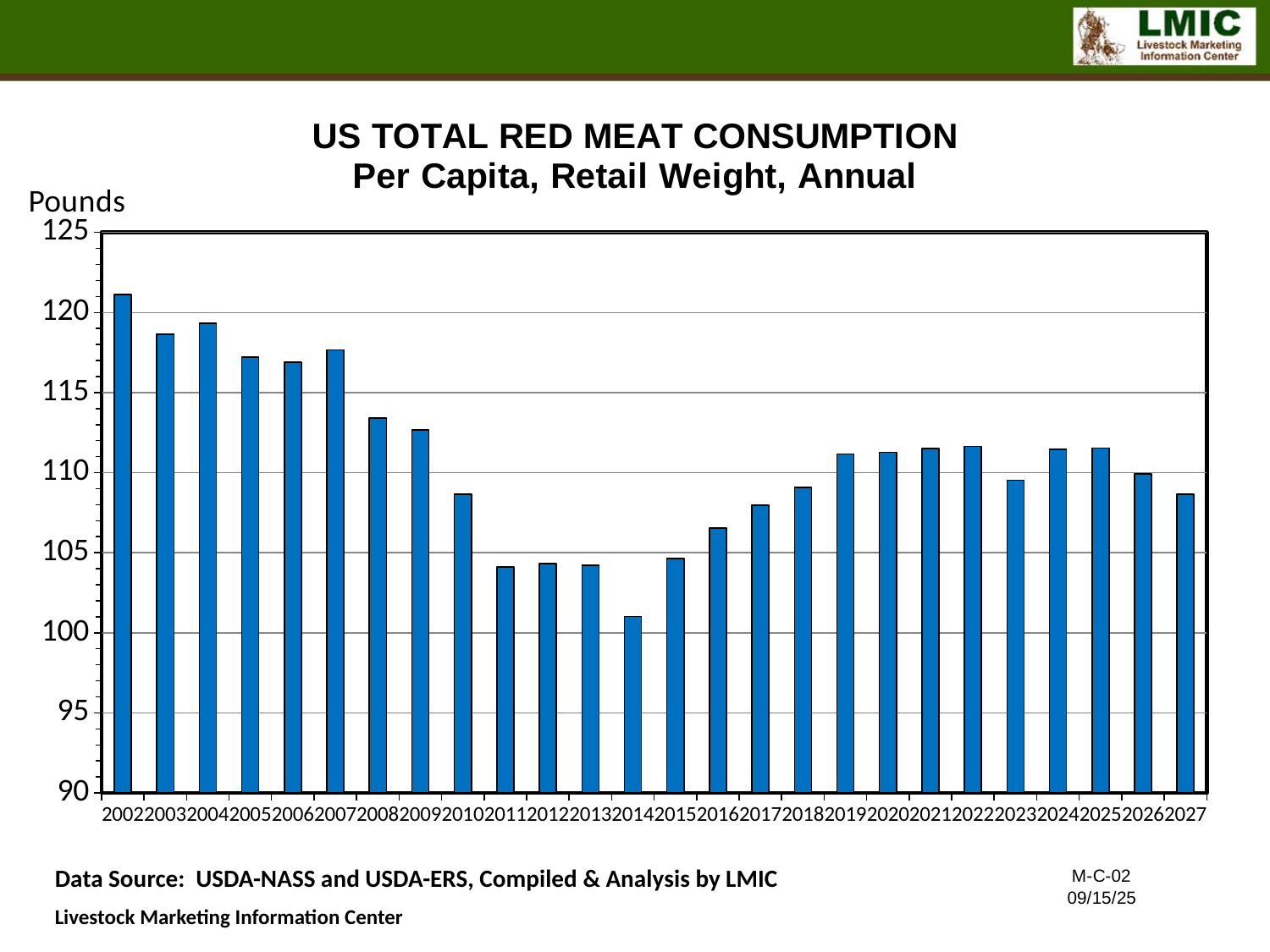
Is the value for 2021 greater or less than 110? greater Which year has the highest per capita red meat consumption? 2002 Which year has the larger value, 2025 or 2026? 2025 Which year has the lowest per capita red meat consumption? 2014 Is the value for 2014 greater or less than 105? less How many years (bars) are plotted on the chart? 26 What kind of chart is shown on the slide? bar chart Do the values generally rise or fall from 2002 to 2014? fall Is the value for 2010 greater or less than 110? less Which year has the larger value, 2007 or 2008? 2007 What unit is shown on the vertical axis of the chart? Pounds